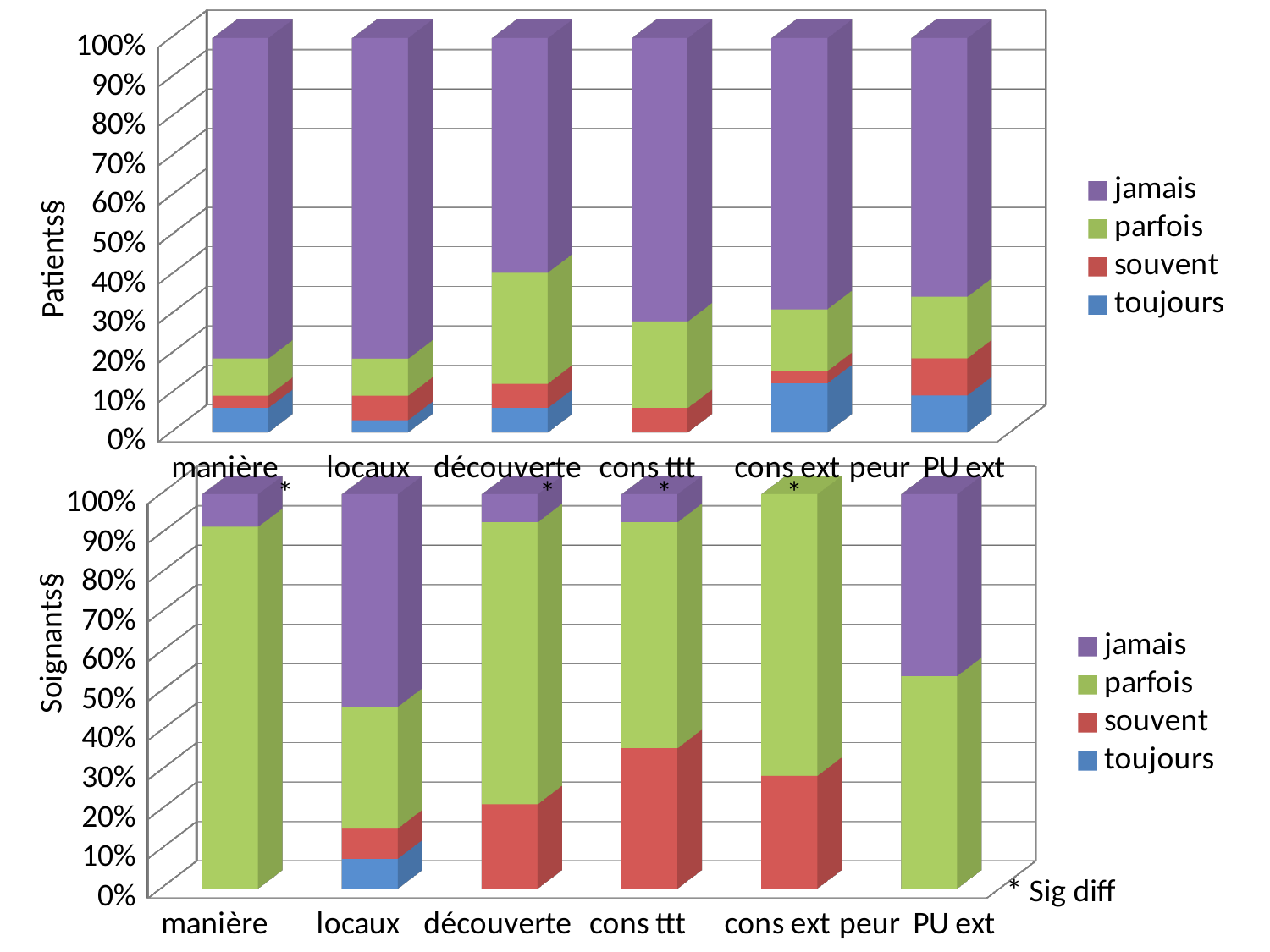
In the top chart (Patients§), is the jamais share for locaux greater or less than 50%? greater According to the footnote, what does the asterisk (*) indicate? Sig diff In the bottom chart (Soignants§), which series makes up the largest share of the manière bar? parfois In the top chart (Patients§), which has the larger parfois share, découverte or locaux? découverte What are the legend entries of the bottom chart? jamais, parfois, souvent, toujours In the bottom chart (Soignants§), is the parfois share for manière greater or less than 80%? greater What kind of charts are shown on the slide? Stacked bar charts In the bottom chart (Soignants§), is the souvent share for cons ttt greater or less than 20%? greater In the top chart (Patients§), which series makes up the largest share of the manière bar? jamais How many series does the legend of the top chart list? 4 In the bottom chart (Soignants§), which series makes up the largest share of the cons ext bar? parfois In the bottom chart (Soignants§), which has the larger jamais share, locaux or PU ext? locaux